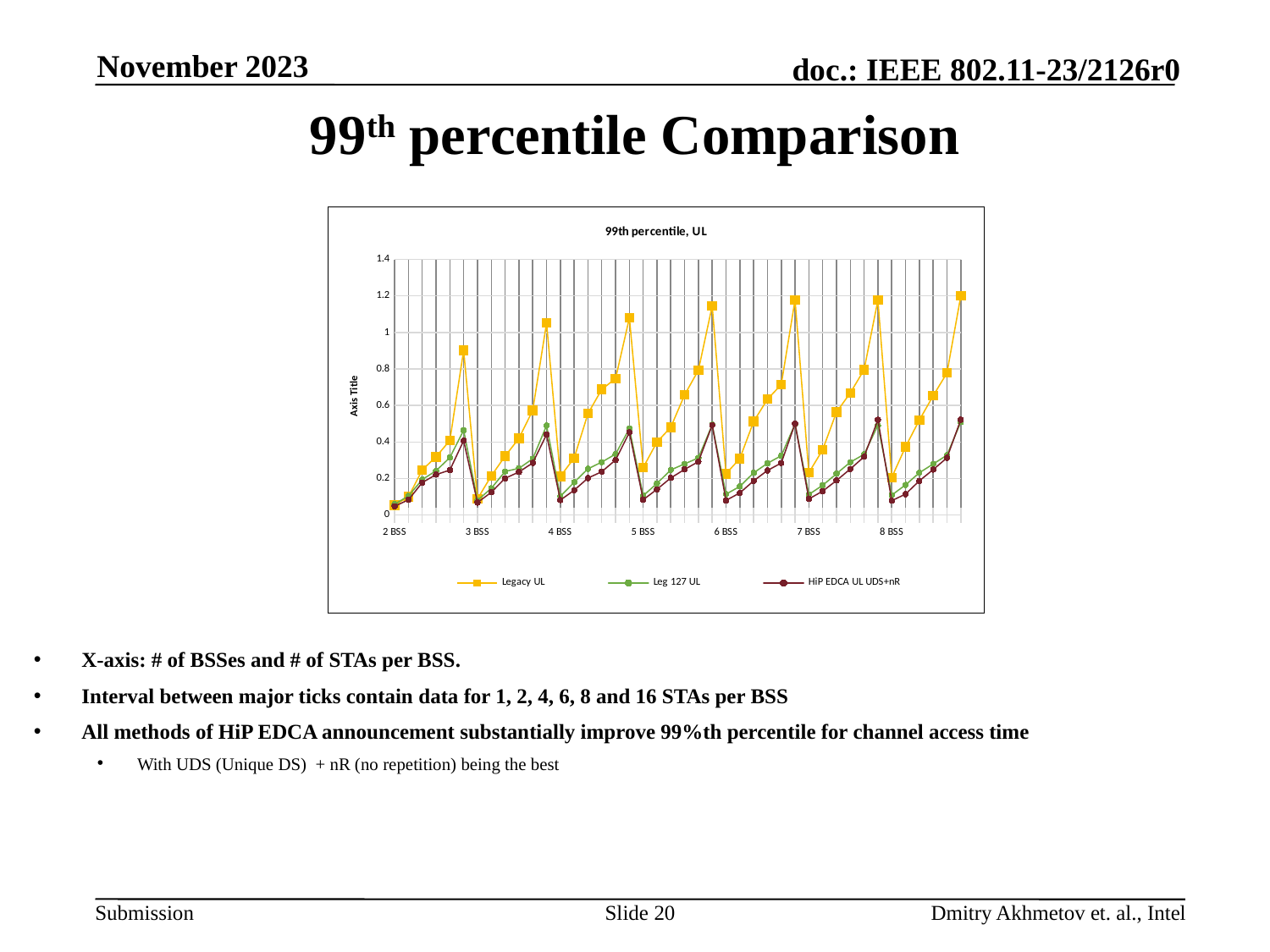
Do the peak values of the Legacy UL series generally rise or fall from 2 BSS to 8 BSS? rise Which series reaches the highest values in the chart? Legacy UL What is the title of the chart? 99th percentile, UL How many series does the chart legend list? 3 Is the peak of the Legacy UL series just before the 3 BSS tick greater or less than 1? less What are the names of the three series in the chart legend? Legacy UL, Leg 127 UL, HiP EDCA UL UDS+nR Is the highest value of the Legacy UL series greater or less than 1? greater How many major category labels are shown on the x-axis of the chart? 7 What is the highest tick value shown on the y-axis of the chart? 1.4 What type of chart is shown on the slide? line chart Is the highest value of the Leg 127 UL series greater or less than 0.6? less Which series has larger peak values, Legacy UL or HiP EDCA UL UDS+nR? Legacy UL